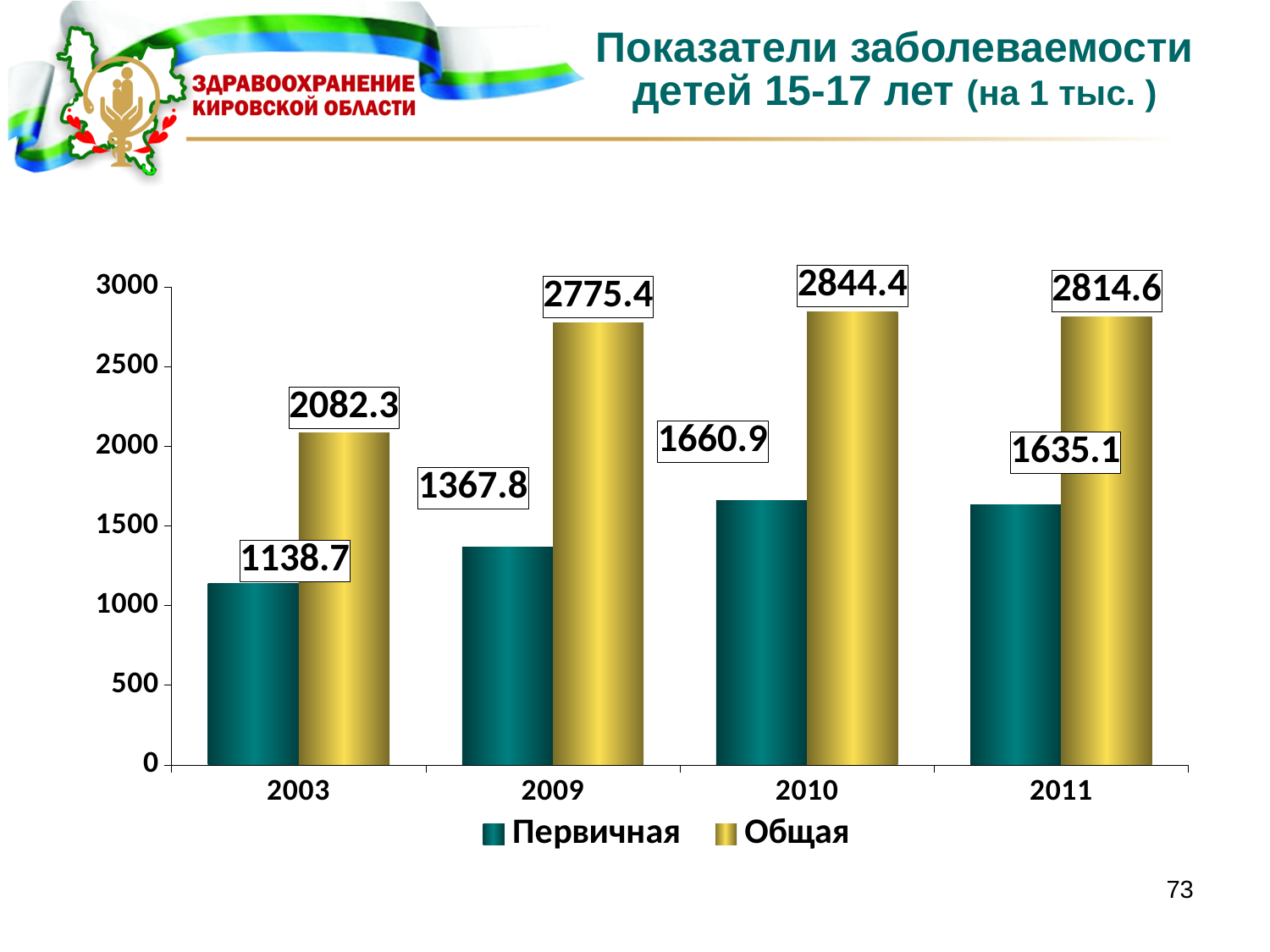
What is the value of Первичная for 2011? 1635.1 What is the difference between Общая and Первичная in 2011? 1179.5 What is the value of Общая for 2009? 2775.4 What is the value of Общая for 2010? 2844.4 Which is larger: Первичная in 2010 or Первичная in 2009? Первичная in 2010 How many series does the legend list? 2 How many years are shown on the x axis? 4 What is the value of Первичная for 2003? 1138.7 Is the value for Общая in 2003 greater or less than 2500? less Which year has the lowest value for Первичная? 2003 What kind of chart is shown on the slide? bar chart Which year has the highest value for Общая? 2010